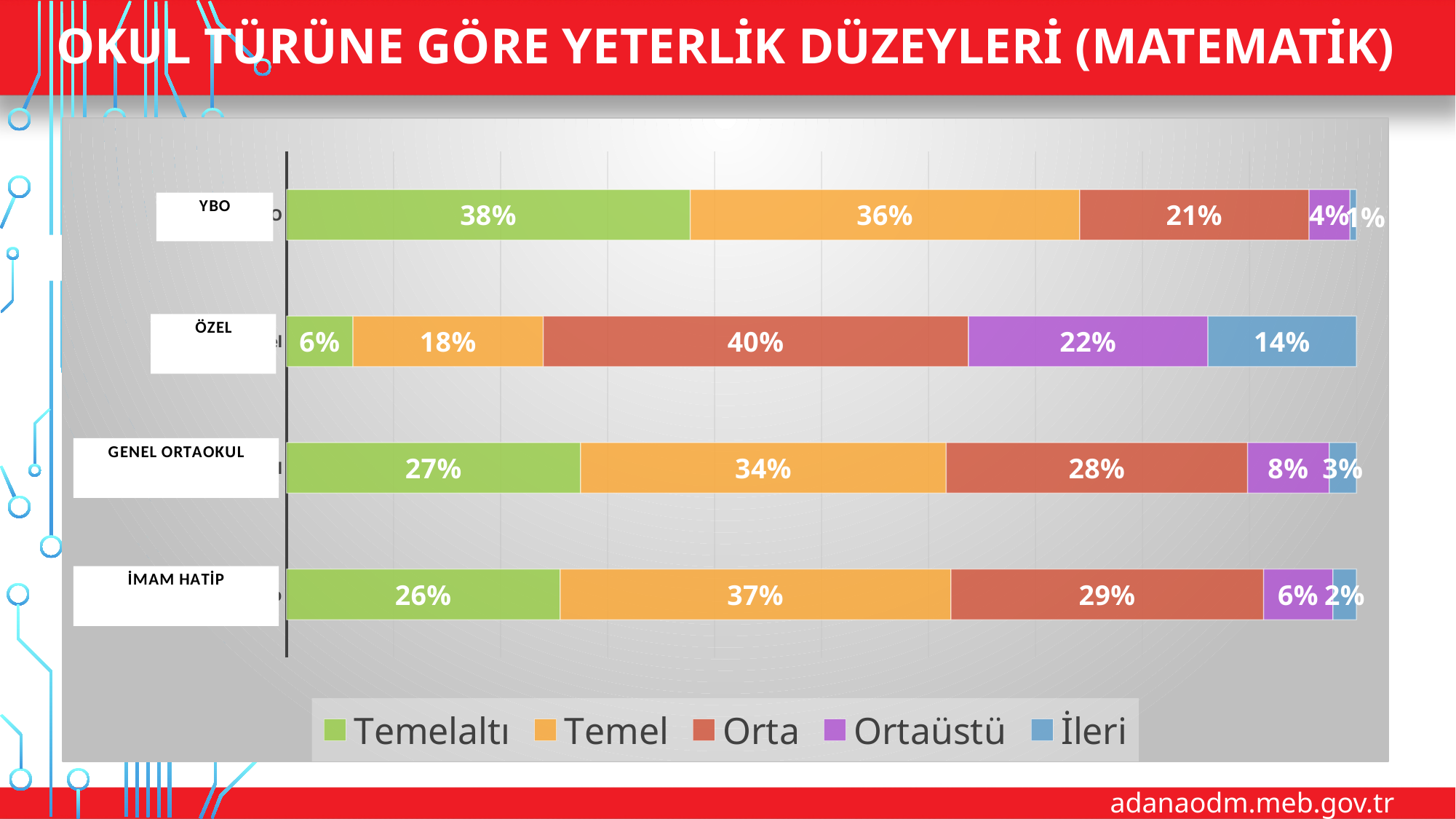
Which is larger, the Temel value for YBO or the Temel value for GENEL ORTAOKUL? YBO How many school types are shown on the chart? 4 What colour represents the Orta series in the legend? Red What is the Orta value for ÖZEL? 40% What is the Temel value for İMAM HATİP? 37% What kind of chart is shown on the slide? Stacked bar chart What is the Temelaltı value for YBO? 38% Which school type has the highest İleri value? ÖZEL Which school type has the lowest Temelaltı value? ÖZEL How many series does the legend list? 5 What is the İleri value for GENEL ORTAOKUL? 3% What is the difference between the Ortaüstü values for ÖZEL and GENEL ORTAOKUL? 14%